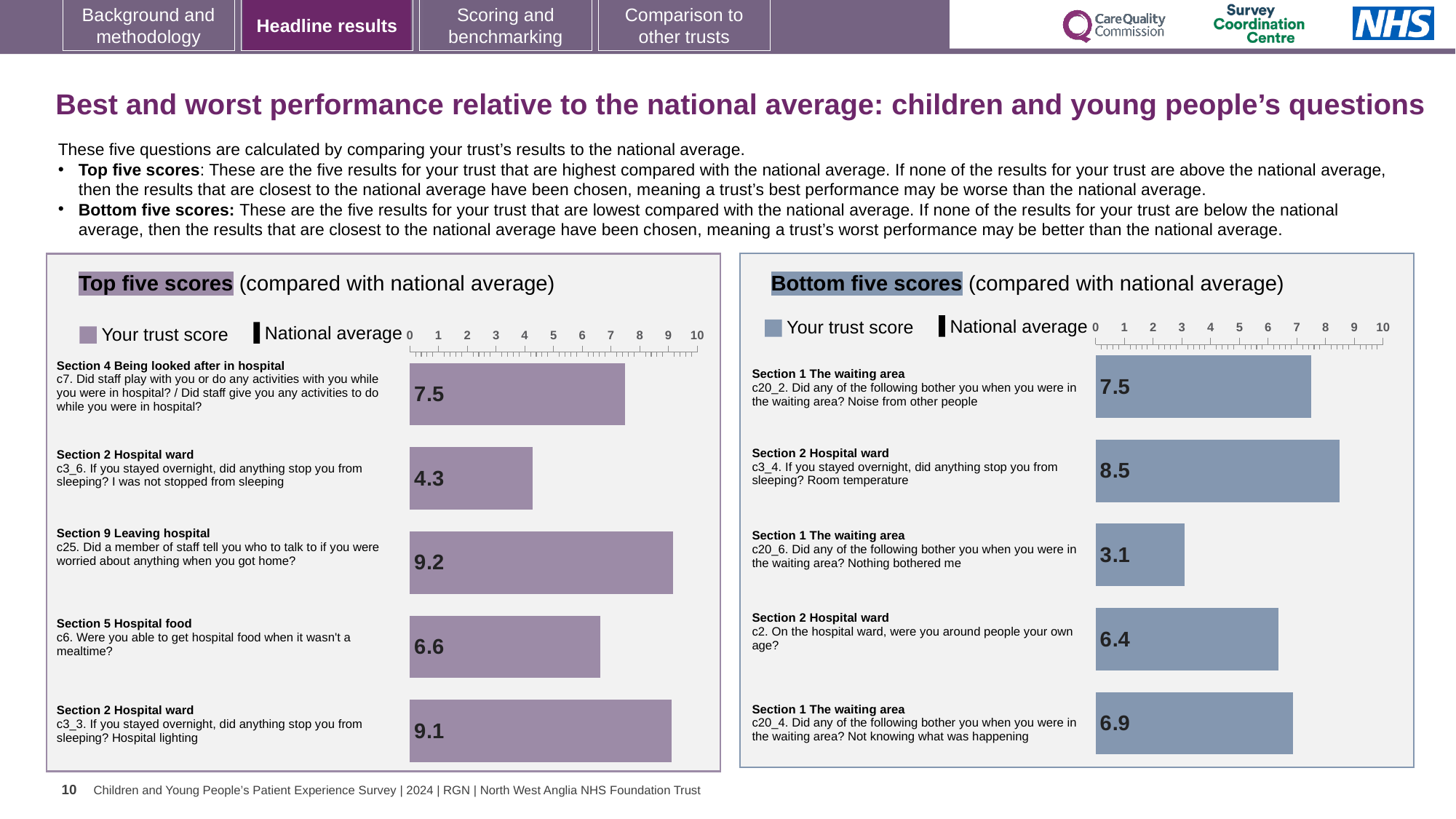
In the Bottom five scores chart, which question has the lowest trust score? c20_6. Nothing bothered me What type of chart is the Bottom five scores chart? Bar chart In the Bottom five scores chart, what is the trust score for c20_4 (Not knowing what was happening)? 6.9 In the Top five scores chart, which question has the highest trust score? c25. Did a member of staff tell you who to talk to if you were worried about anything when you got home? In the Top five scores chart, what is the trust score for c3_6 (I was not stopped from sleeping)? 4.3 In the Bottom five scores chart, what is the trust score for c3_4 (Room temperature)? 8.5 How many series does the legend of the Top five scores chart list? 2 In the Top five scores chart, what is the trust score for c25 (Did a member of staff tell you who to talk to if you were worried about anything when you got home?)? 9.2 How many questions are plotted in the Top five scores chart? 5 In the Top five scores chart, what is the difference between the trust scores for c25 and c3_6? 4.9 In the Bottom five scores chart, what is the difference between the trust scores for c3_4 and c20_6? 5.4 In the Bottom five scores chart, which has the larger trust score: c2 (around people your own age) or c20_4 (Not knowing what was happening)? c20_4